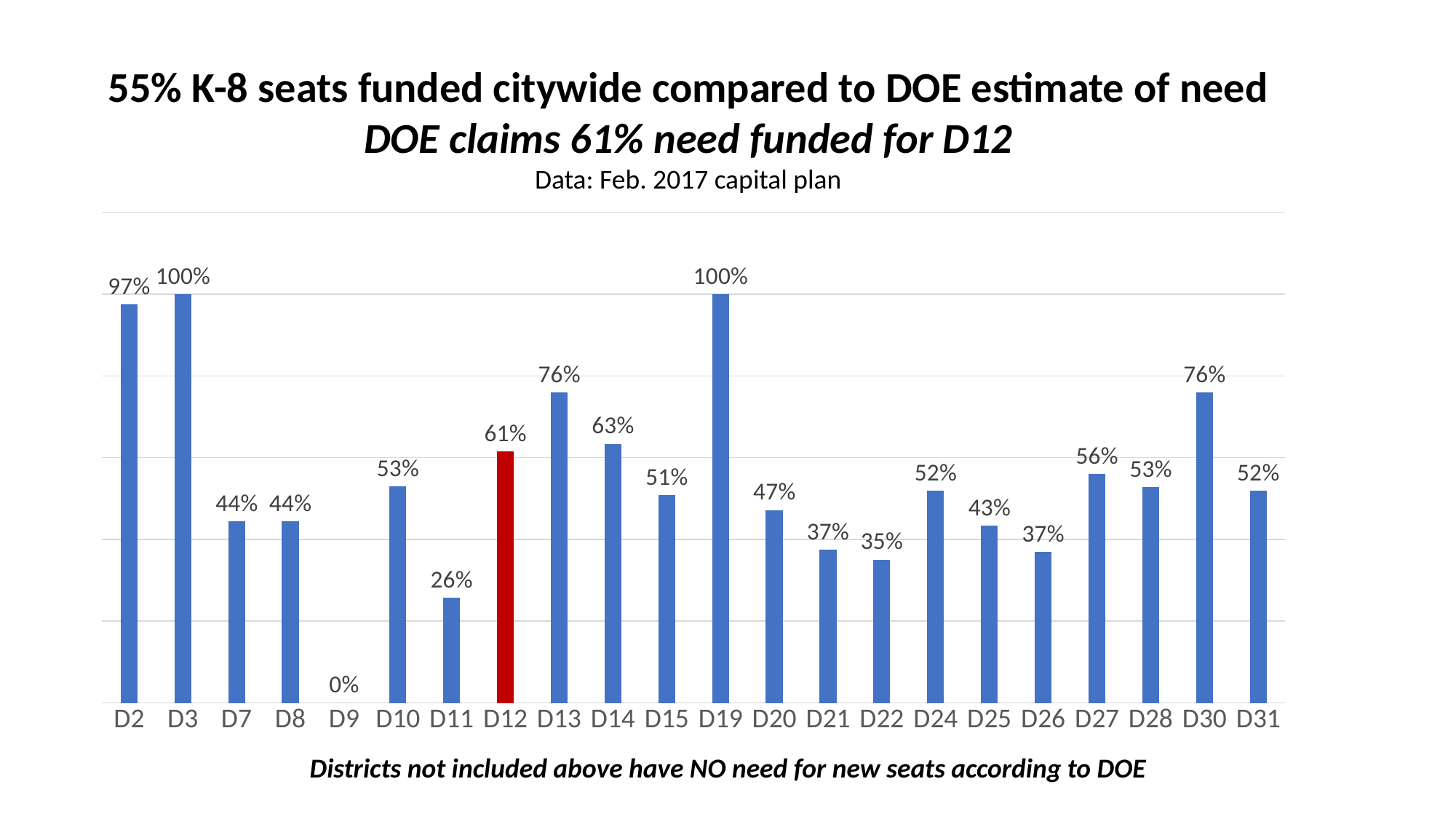
What is the value for D22? 35% Which is larger, the value for D14 or the value for D27? D14 What is the highest value shown on the chart? 100% What is the value for D12? 61% Which district has the lowest value? D9 What is the value for D11? 26% Which district's bar is coloured red? D12 What is the difference between the values for D13 and D12? 15% What kind of chart is this? Bar chart How many districts are shown on the chart? 22 What is the difference between the values for D2 and D3? 3% What is the value for D30? 76%